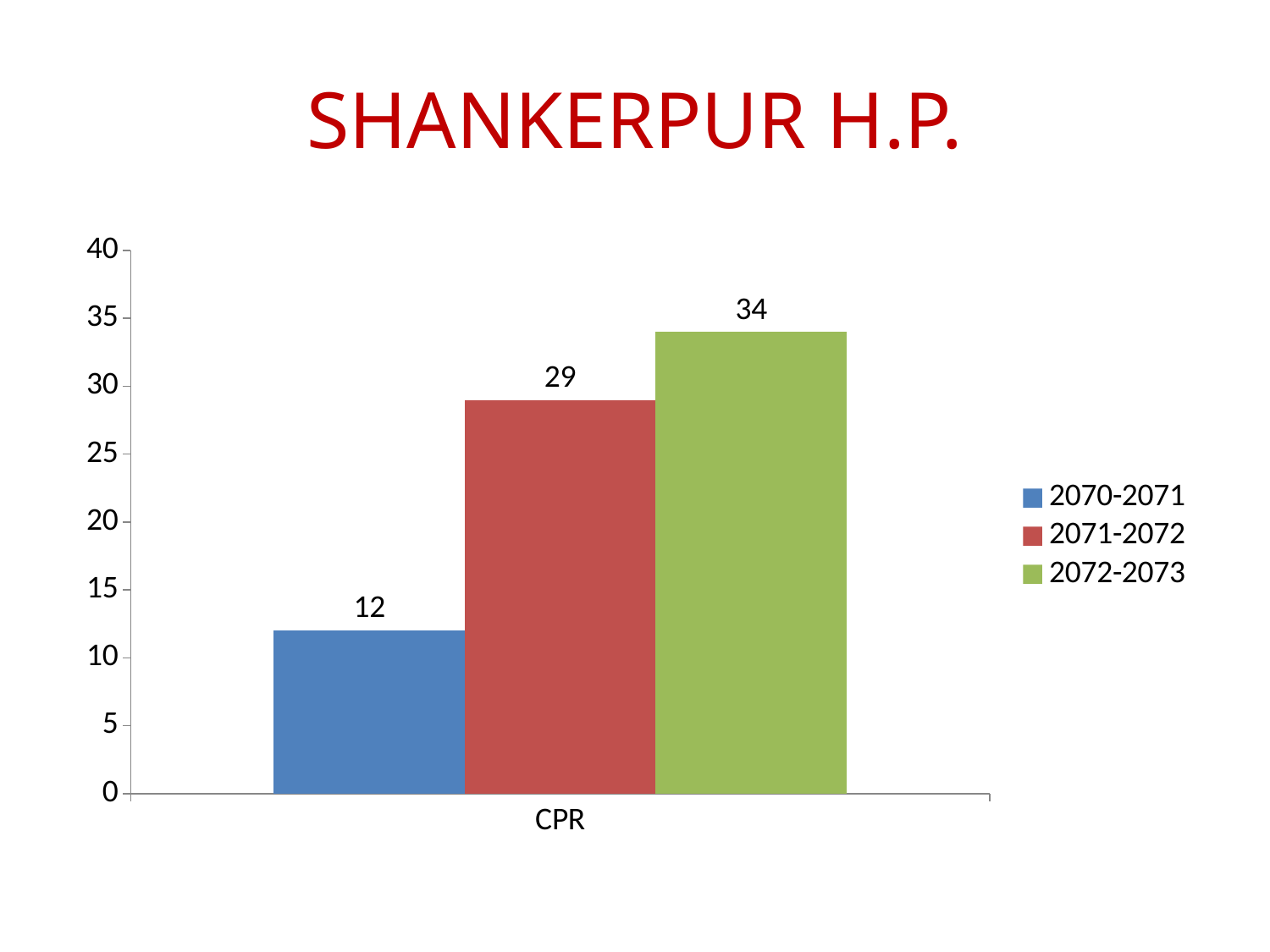
Which year has the lowest CPR value? 2070-2071 What is the difference between the CPR values for 2071-2072 and 2070-2071? 17 What is the CPR value for 2071-2072? 29 Is the CPR value for 2071-2072 greater or less than 25? greater What is the CPR value for 2070-2071? 12 Which year has the highest CPR value? 2072-2073 How many series does the legend list? 3 What is the CPR value for 2072-2073? 34 What is the title of the slide? SHANKERPUR H.P. What kind of chart is shown on the slide? bar chart Which is larger, the CPR value for 2071-2072 or for 2072-2073? 2072-2073 What is the difference between the CPR values for 2072-2073 and 2070-2071? 22